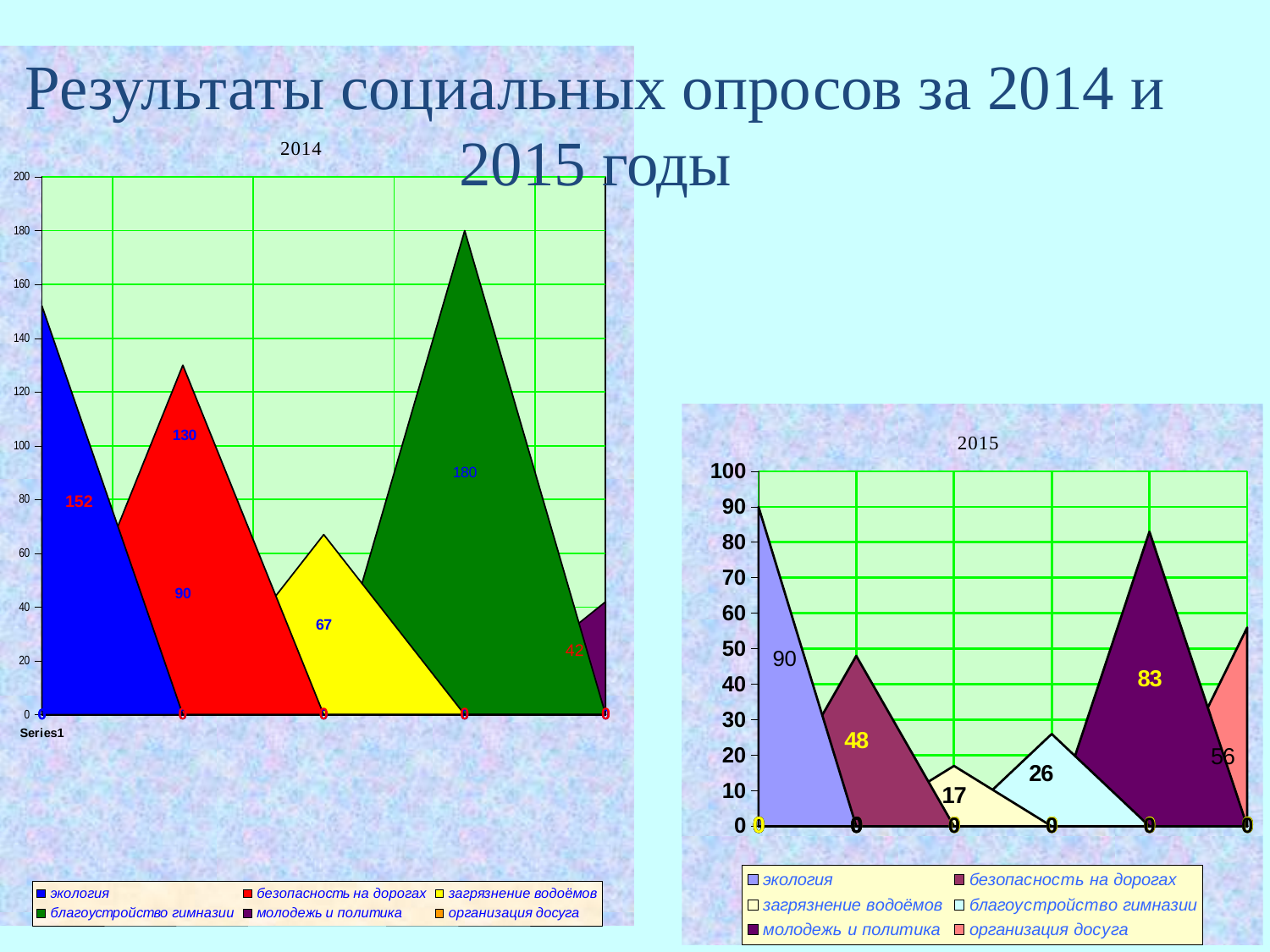
In the 2015 chart, what is the value for экология? 90 What kind of chart is the 2015 chart? area chart In the 2015 chart, what is the difference between the values for экология and безопасность на дорогах? 42 In the 2015 chart, which series has the lowest value? загрязнение водоёмов In the 2015 chart, what is the value for молодежь и политика? 83 In the 2015 chart, which series has the highest value? экология How many series does the legend of the 2015 chart list? 6 In the 2014 chart, what is the value for благоустройство гимназии? 180 In the 2014 chart, what is the difference between the values for благоустройство гимназии and экология? 28 In the 2015 chart, which is larger: организация досуга or безопасность на дорогах? организация досуга In the 2014 chart, which series has the highest value? благоустройство гимназии In the 2015 chart, what is the value for загрязнение водоёмов? 17